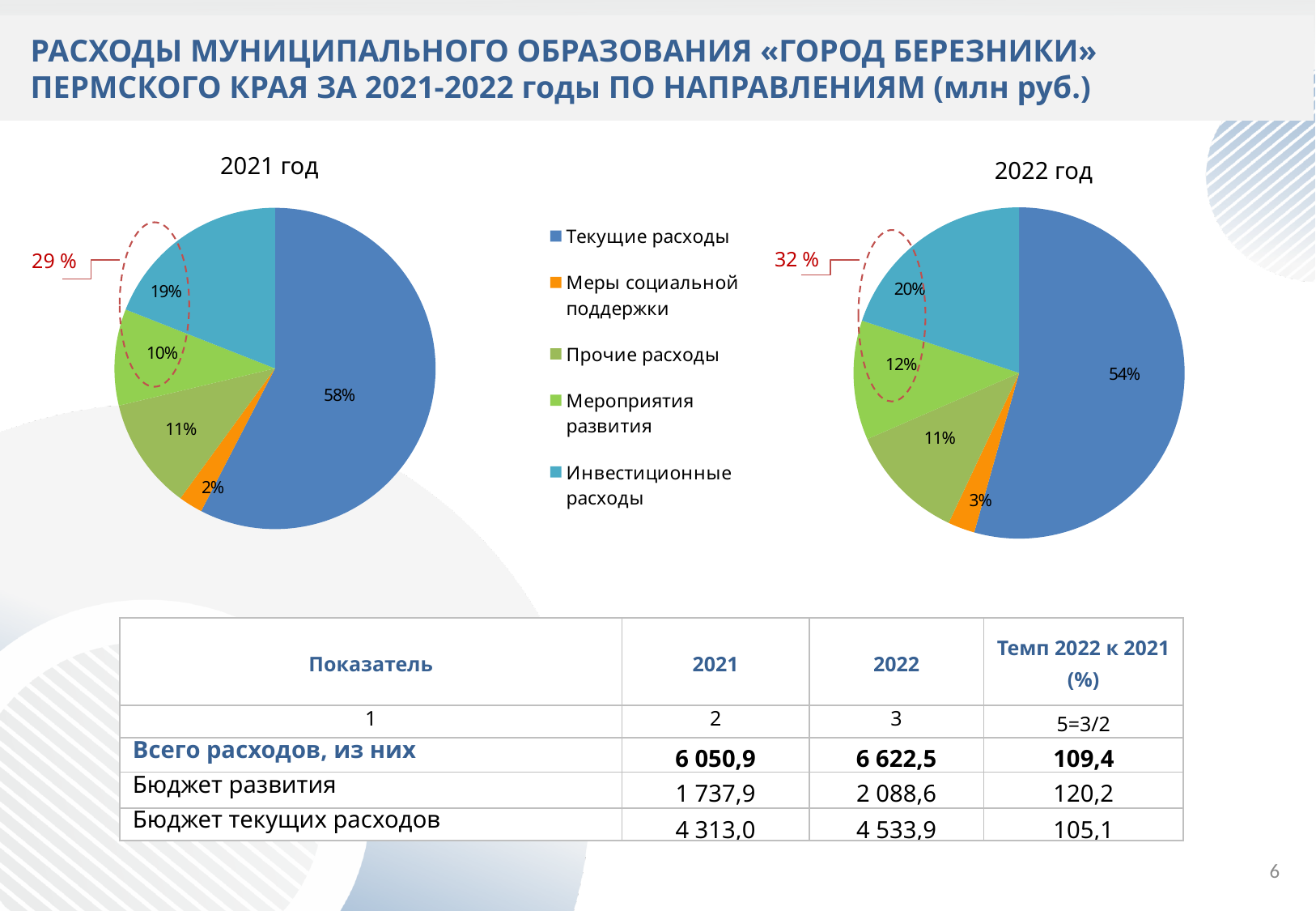
In the 2021 год pie chart, what share do Текущие расходы have? 58% How many categories does the legend list for the pie charts? 5 In the 2022 год pie chart, what share do Меры социальной поддержки have? 3% In the 2021 год pie chart, what combined share is marked by the red dashed circle? 29 % In the 2021 год pie chart, what share do Инвестиционные расходы have? 19% In the 2022 год pie chart, what share do Мероприятия развития have? 12% In the 2021 год pie chart, which category has the smallest share? Меры социальной поддержки In the 2022 год pie chart, what share do Текущие расходы have? 54% In the 2022 год pie chart, which category has the largest share? Текущие расходы In the 2022 год pie chart, which is larger: the share of Прочие расходы or the share of Мероприятия развития? Мероприятия развития What is the difference between the share of Текущие расходы in the 2021 год chart and in the 2022 год chart? 4% What type of chart is used to show the 2021 год expenditures? Pie chart